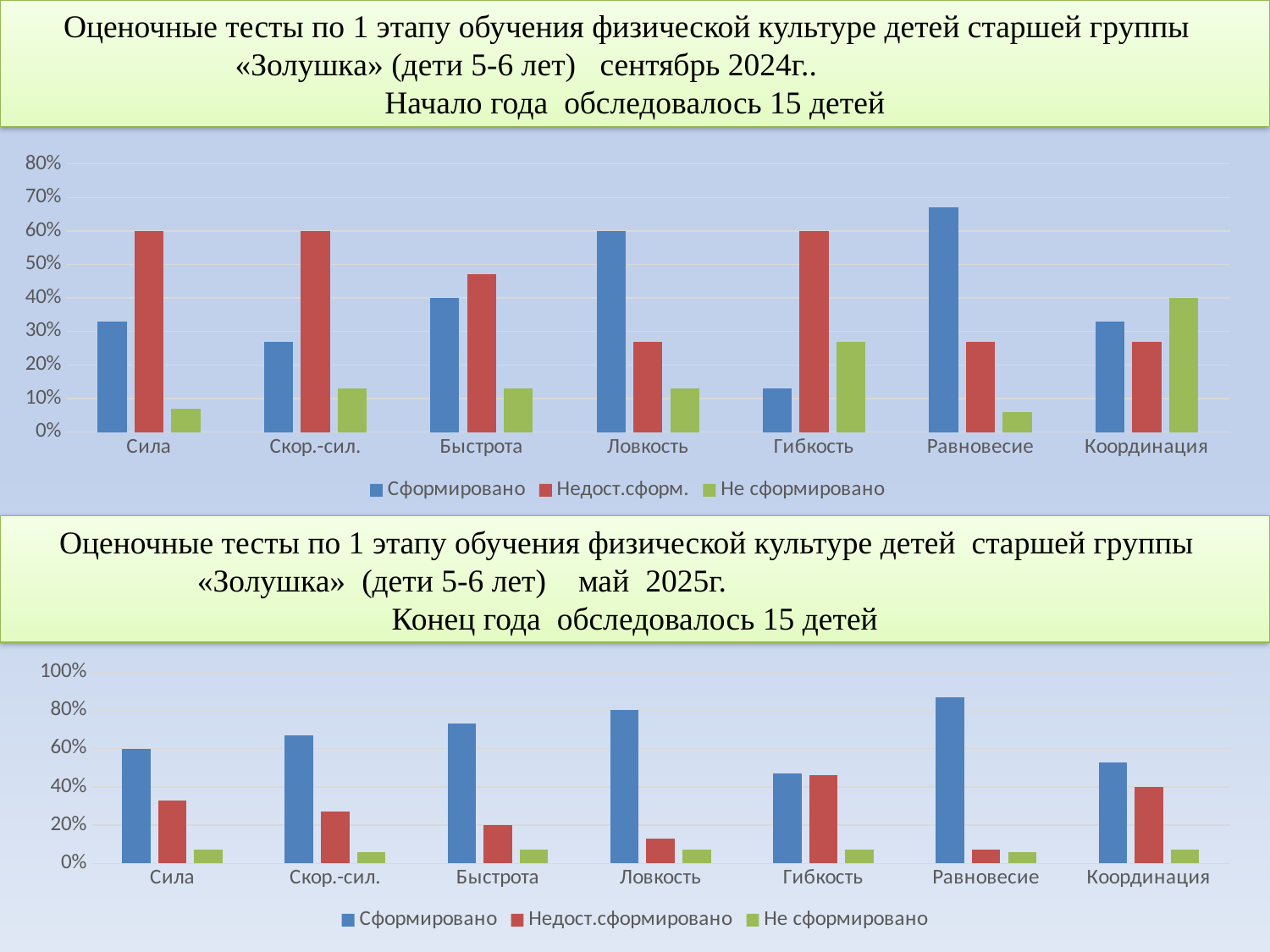
In the top chart (сентябрь 2024г.), which category has the highest value for Сформировано? Равновесие In the bottom chart (май 2025г.), is the value for Сформировано in Ловкость greater or less than 60%? greater How many series does the legend of the top chart (сентябрь 2024г.) list? 3 In the top chart (сентябрь 2024г.), is the value for Недост.сформ. in Сила greater or less than 50%? greater In the bottom chart (май 2025г.), which is larger for Сила: Сформировано or Недост.сформировано? Сформировано How many categories are shown on the x axis of the top chart (сентябрь 2024г.)? 7 In the bottom chart (май 2025г.), which category has the lowest value for Сформировано? Гибкость In the top chart (сентябрь 2024г.), is the value for Не сформировано in Координация greater or less than 30%? greater What kind of chart is the bottom chart (май 2025г.)? bar chart In the bottom chart (май 2025г.), which category has the highest value for Сформировано? Равновесие